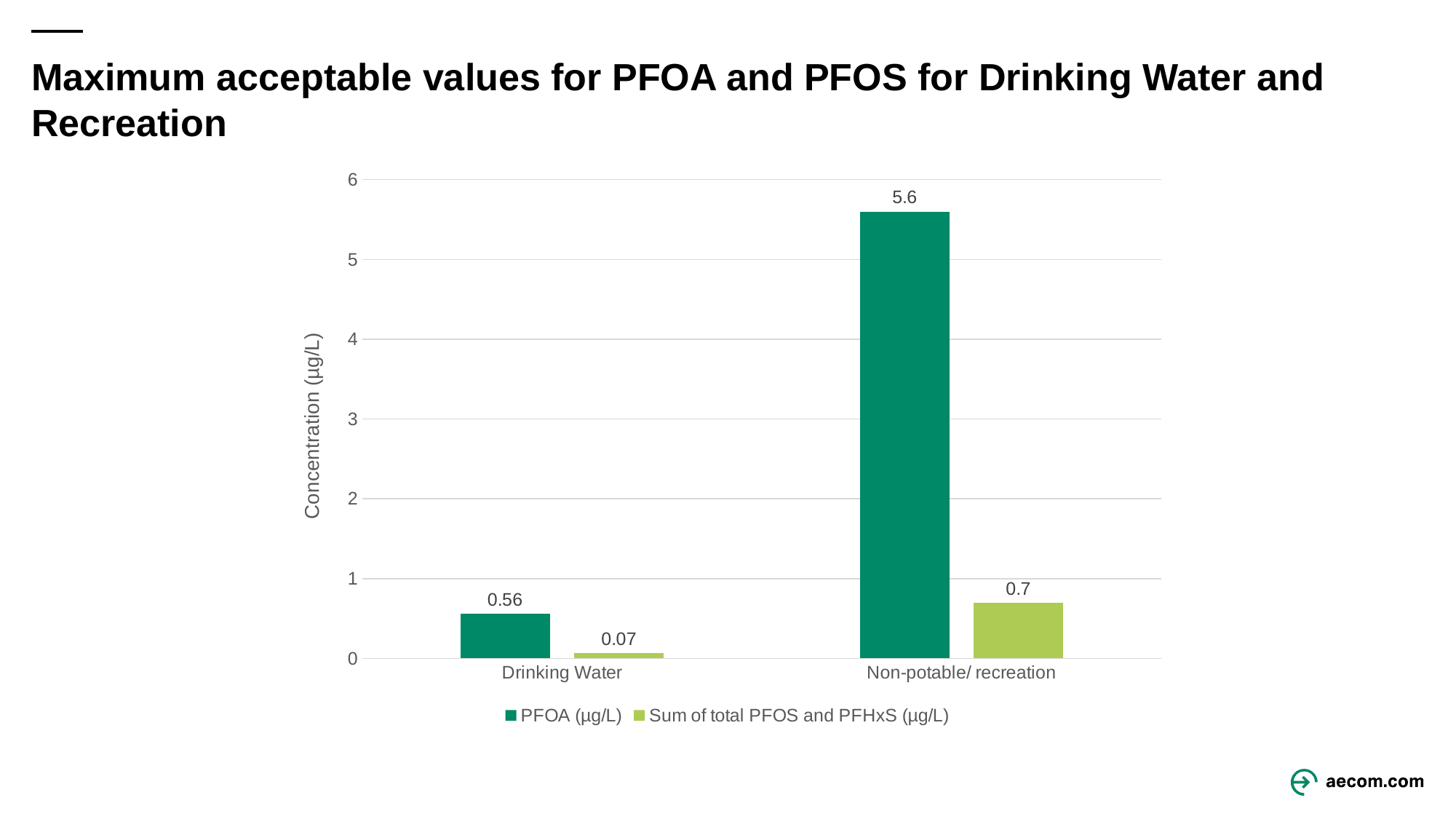
What is the difference between the PFOA (µg/L) values for Non-potable/ recreation and Drinking Water? 5.04 What is the PFOA (µg/L) value for Non-potable/ recreation? 5.6 Which category has the highest PFOA (µg/L) value? Non-potable/ recreation How many series does the legend list? 2 What kind of chart is shown on the slide? Bar chart What is the Sum of total PFOS and PFHxS (µg/L) value for Non-potable/ recreation? 0.7 Which bar on the chart has the lowest value? Sum of total PFOS and PFHxS (µg/L) for Drinking Water How many categories are shown on the x axis? 2 What is the Sum of total PFOS and PFHxS (µg/L) value for Drinking Water? 0.07 Is the PFOA (µg/L) value for Non-potable/ recreation greater or less than 5? greater Which is larger for Drinking Water: PFOA (µg/L) or Sum of total PFOS and PFHxS (µg/L)? PFOA (µg/L) What is the PFOA (µg/L) value for Drinking Water? 0.56